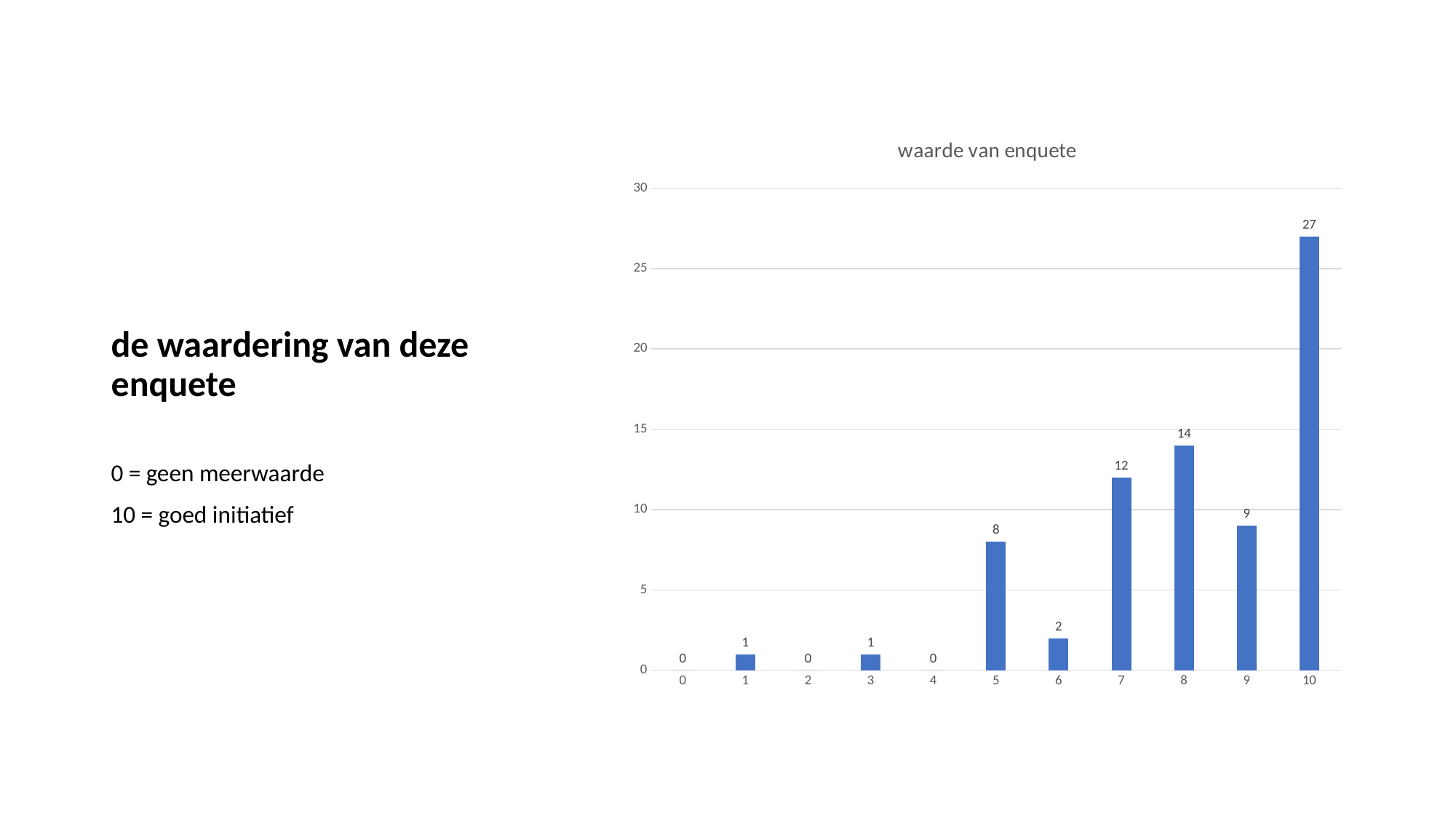
How many categories are shown on the x axis? 11 What is the value for category 5? 8 What is the difference between the values for categories 10 and 8? 13 What is the title of the chart? waarde van enquete Which is larger, the value for category 7 or the value for category 9? 7 What is the value for category 7? 12 What is the difference between the values for categories 8 and 9? 5 Which category has the highest value? 10 Is the value for category 10 greater or less than 25? greater What is the value for category 10? 27 What is the value for category 6? 2 What kind of chart is shown? bar chart